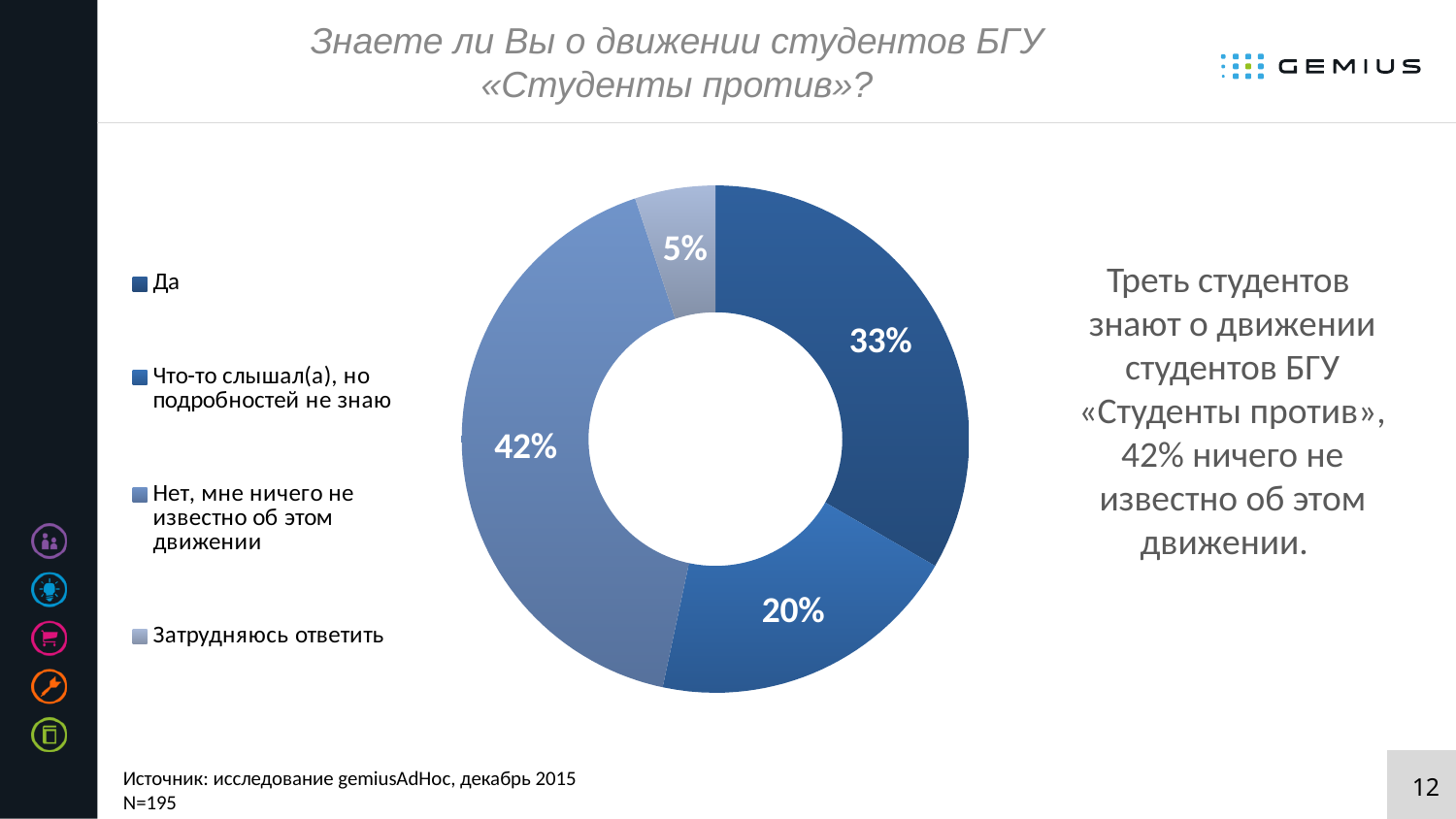
How many answer options (slices) does the pie chart show? 4 What share of respondents answered «Что-то слышал(а), но подробностей не знаю»? 20% Which answer option has the smallest share of the pie? Затрудняюсь ответить What is the title of the chart on the slide? Знаете ли Вы о движении студентов БГУ «Студенты против»? What share of respondents answered «Затрудняюсь ответить»? 5% How many entries does the legend list? 4 Which is larger: the share for «Да» or the share for «Что-то слышал(а), но подробностей не знаю»? Да What share of respondents answered «Нет, мне ничего не известно об этом движении»? 42% What kind of chart is shown on the slide? Pie chart (donut) What share of respondents answered «Да»? 33% Which answer option has the largest share of the pie? Нет, мне ничего не известно об этом движении What is the difference in percentage points between «Нет, мне ничего не известно об этом движении» and «Да»? 9 percentage points